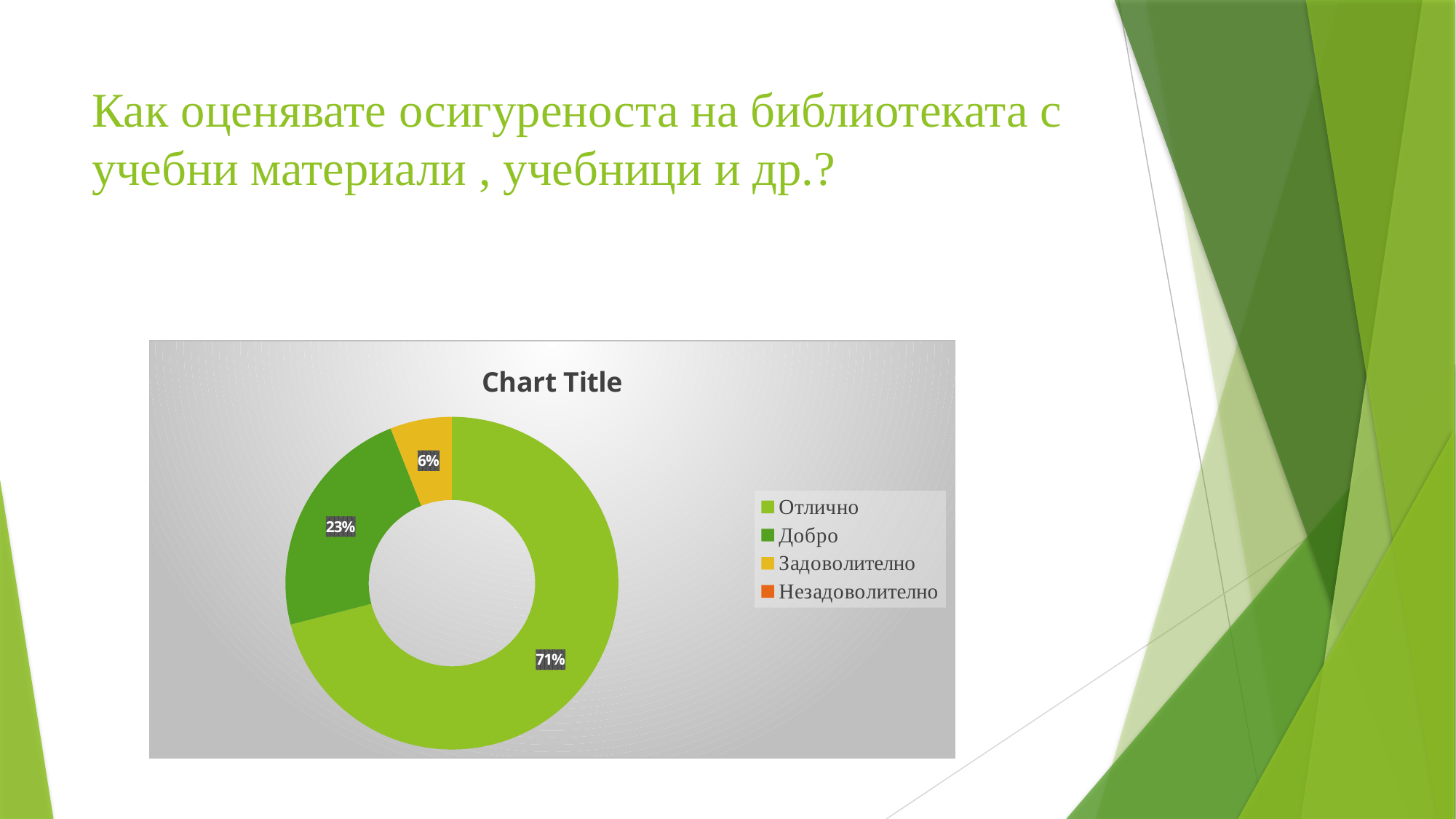
What share of the doughnut chart is labelled Отлично? 71% Which legend entry is shown in orange? Незадоволително What is the difference in percentage points between the Отлично and Добро shares? 48% What is the title shown on the chart? Chart Title How many entries does the legend of the chart list? 4 What share of the doughnut chart is labelled Задоволително? 6% What is the difference in percentage points between the Добро and Задоволително shares? 17% Which of the labelled slices has the smallest share in the doughnut chart? Задоволително Which share is larger, Добро or Задоволително? Добро What kind of chart is shown on the slide? Doughnut chart What share of the doughnut chart is labelled Добро? 23% Which category has the largest share in the doughnut chart? Отлично